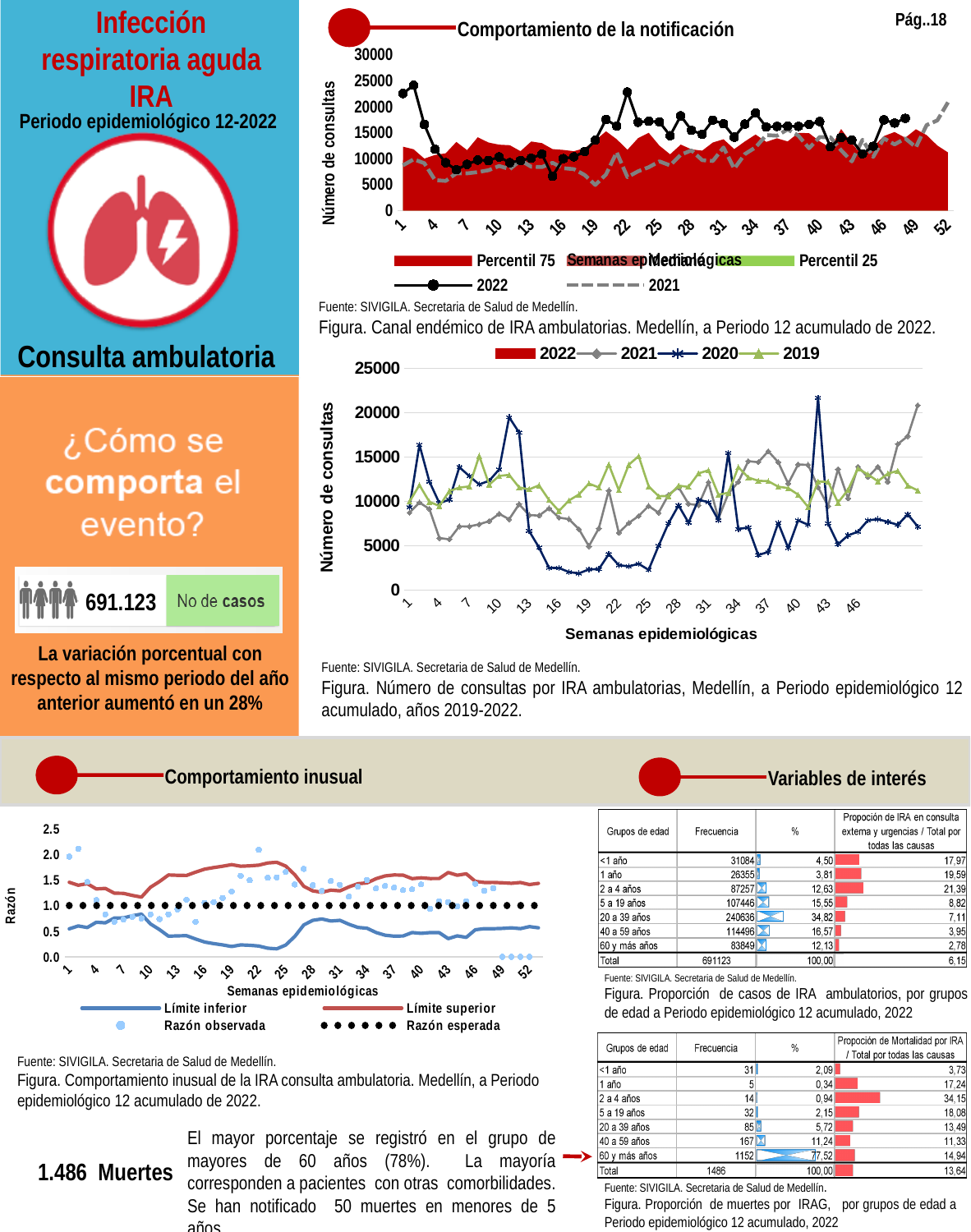
In the 'Comportamiento inusual' chart, how many series does the legend list? 4 In the chart titled 'Comportamiento de la notificación', is the 2022 value at week 22 greater or less than 20000? greater In the 'Comportamiento inusual' chart, is the 'Límite superior' value at week 22 greater or less than 1.5? greater What kind of chart is the 'Número de consultas por IRA ambulatorias' chart for years 2019-2022? line chart In the chart of 'Número de consultas por IRA ambulatorias' (years 2019-2022), is the 2020 value at week 10 greater or less than 15000? less In the chart titled 'Comportamiento de la notificación', what is the highest value shown on the y axis? 30000 In the chart of 'Número de consultas por IRA ambulatorias' (years 2019-2022), what is the label of the y axis? Número de consultas In the chart titled 'Comportamiento de la notificación', how many series does the legend list? 5 In the chart of 'Número de consultas por IRA ambulatorias' (years 2019-2022), how many series does the legend list? 4